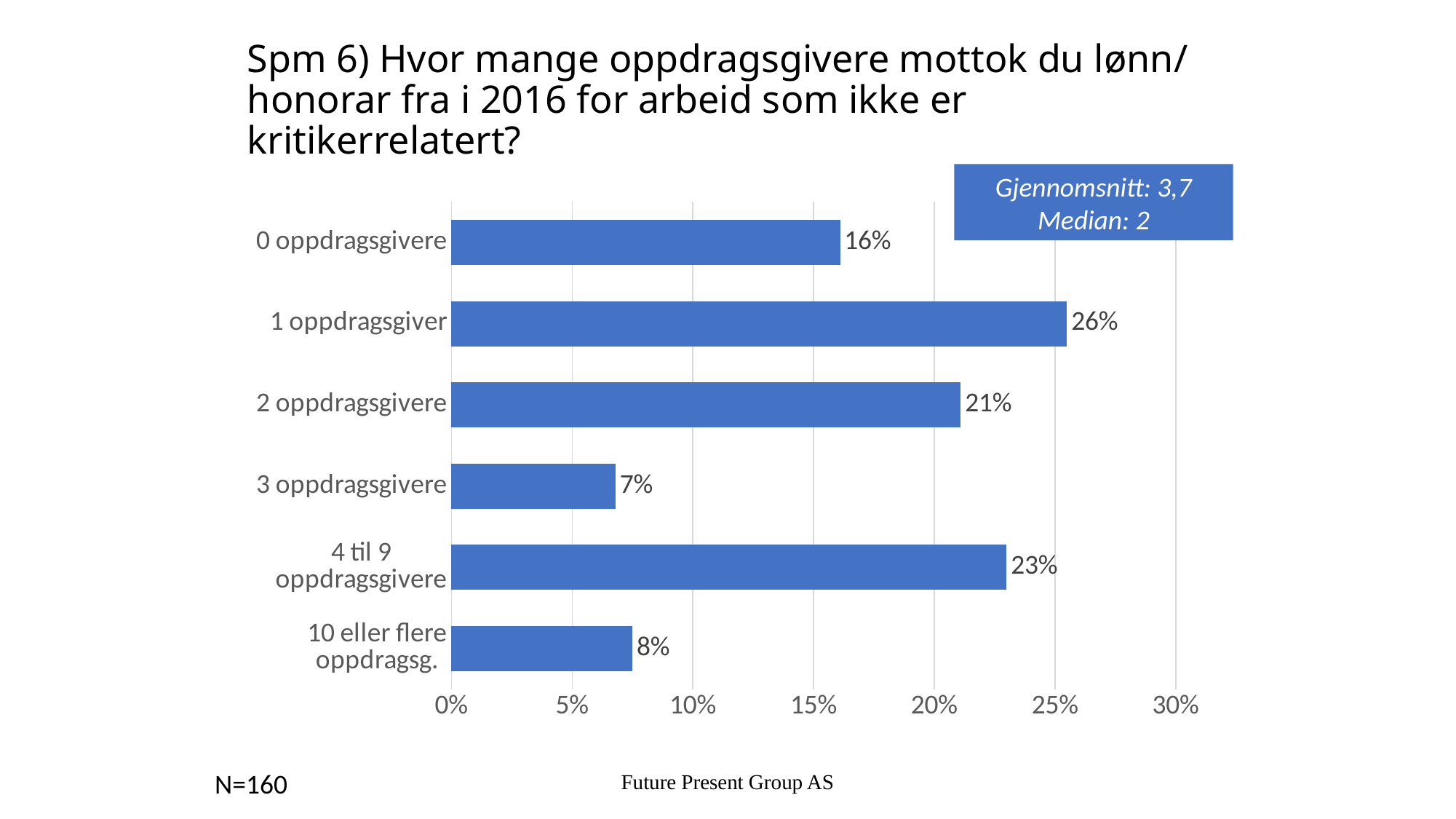
What median value is stated in the box on the chart? 2 Is the value for "0 oppdragsgivere" greater or less than 20%? less What is the sample size (N) stated on the slide? 160 Which is larger, the value for "2 oppdragsgivere" or the value for "4 til 9 oppdragsgivere"? 4 til 9 oppdragsgivere What is the value for "4 til 9 oppdragsgivere"? 23% Which category has the highest value? 1 oppdragsgiver What kind of chart is shown on the slide? bar chart Which category has the lowest value? 3 oppdragsgivere What is the difference between the values for "1 oppdragsgiver" and "2 oppdragsgivere"? 5% What is the value for "0 oppdragsgivere"? 16% How many categories are shown in the chart? 6 What is the value for "1 oppdragsgiver"? 26%